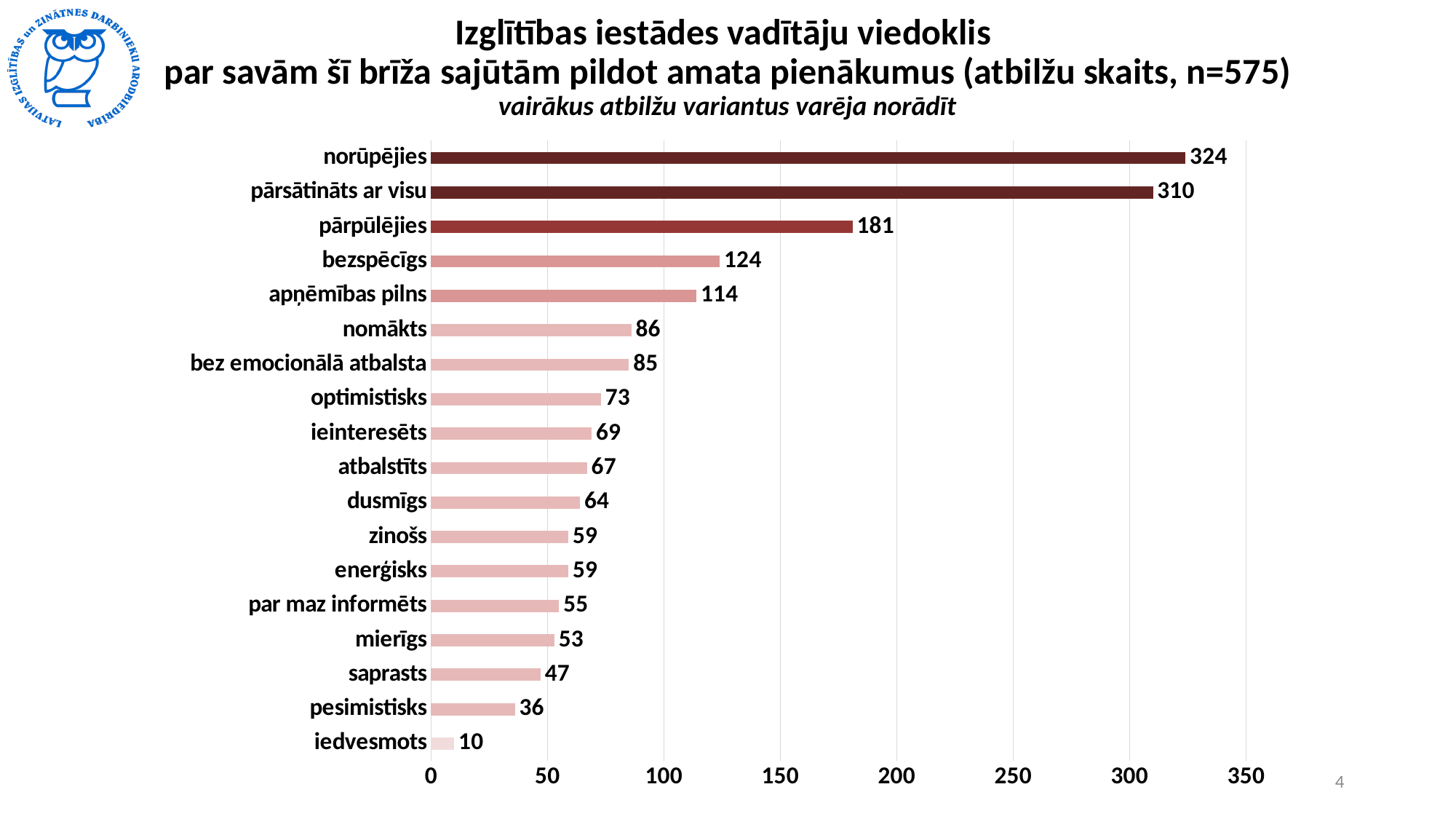
What is the value for "pesimistisks"? 36 What is the value for "norūpējies"? 324 Which category has the lowest value? iedvesmots What is the value of the highest tick label on the horizontal axis? 350 What is the difference between the values for "norūpējies" and "pārsātināts ar visu"? 14 Is the value for "apņēmības pilns" greater or less than 100? greater How many categories are shown in the chart? 18 What kind of chart is shown on the slide? bar chart What is the value for "bez emocionālā atbalsta"? 85 Which is larger, the value for "optimistisks" or the value for "dusmīgs"? optimistisks What is the difference between the values for "pārpūlējies" and "bezspēcīgs"? 57 Which category has the highest value? norūpējies